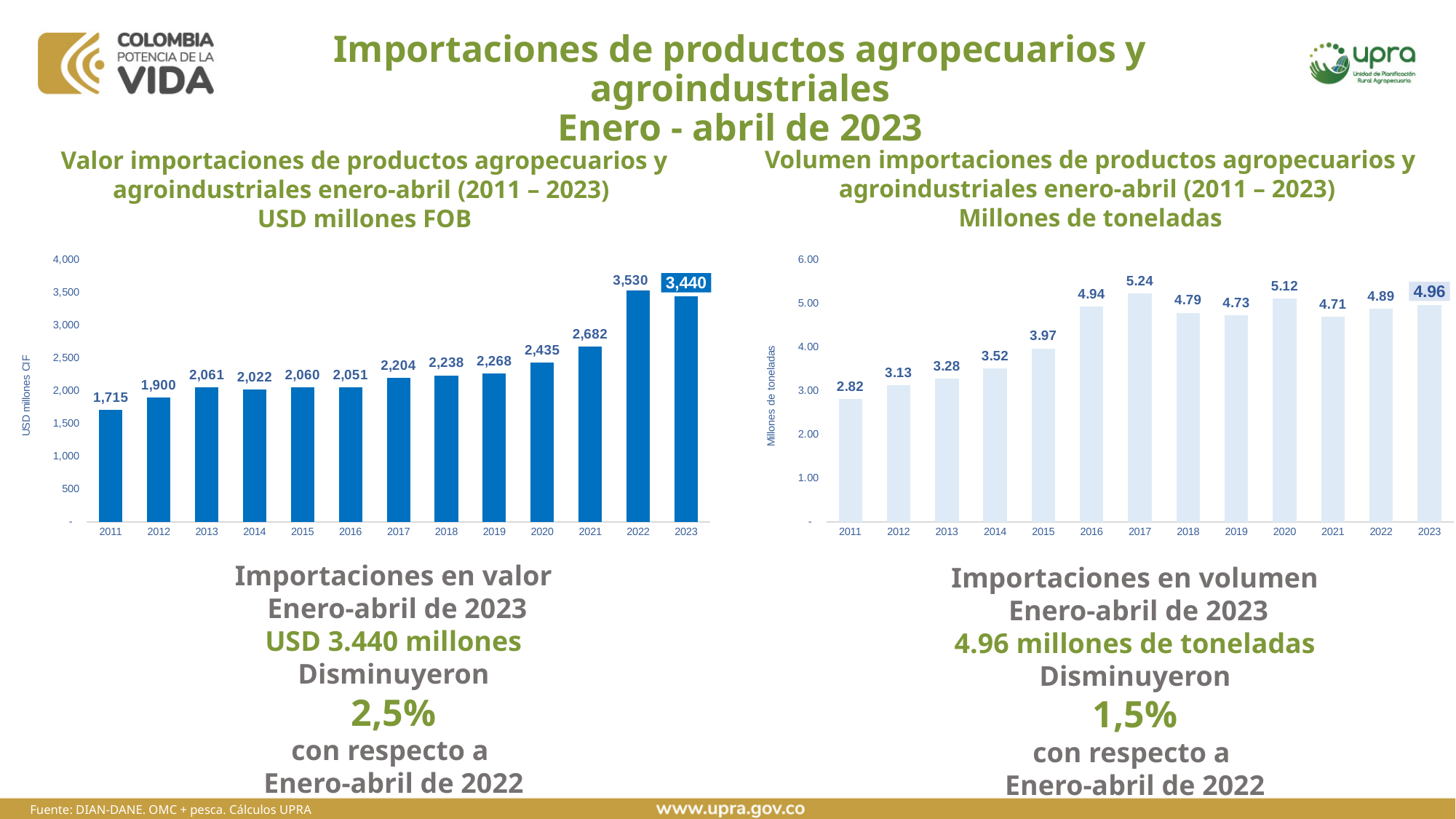
In the right chart (Volumen importaciones, Millones de toneladas), what is the value for 2023? 4.96 In the left chart (Valor importaciones, USD millones FOB), which year has the highest value? 2022 In the left chart (Valor importaciones, USD millones FOB), what is the value for 2011? 1,715 In the left chart (Valor importaciones, USD millones FOB), how many years are plotted? 13 In the right chart (Volumen importaciones, Millones de toneladas), what is the difference between the 2016 and 2015 values? 0.97 What type of chart is the right chart (Volumen importaciones, Millones de toneladas)? Bar chart In the right chart (Volumen importaciones, Millones de toneladas), is the value for 2020 larger than the value for 2021? Yes In the left chart (Valor importaciones, USD millones FOB), what is the value for 2023? 3,440 In the left chart (Valor importaciones, USD millones FOB), which year has the lowest value? 2011 In the left chart (Valor importaciones, USD millones FOB), what is the difference between the 2022 and 2023 values? 90 In the right chart (Volumen importaciones, Millones de toneladas), what is the value for 2017? 5.24 In the right chart (Volumen importaciones, Millones de toneladas), which year has the lowest value? 2011